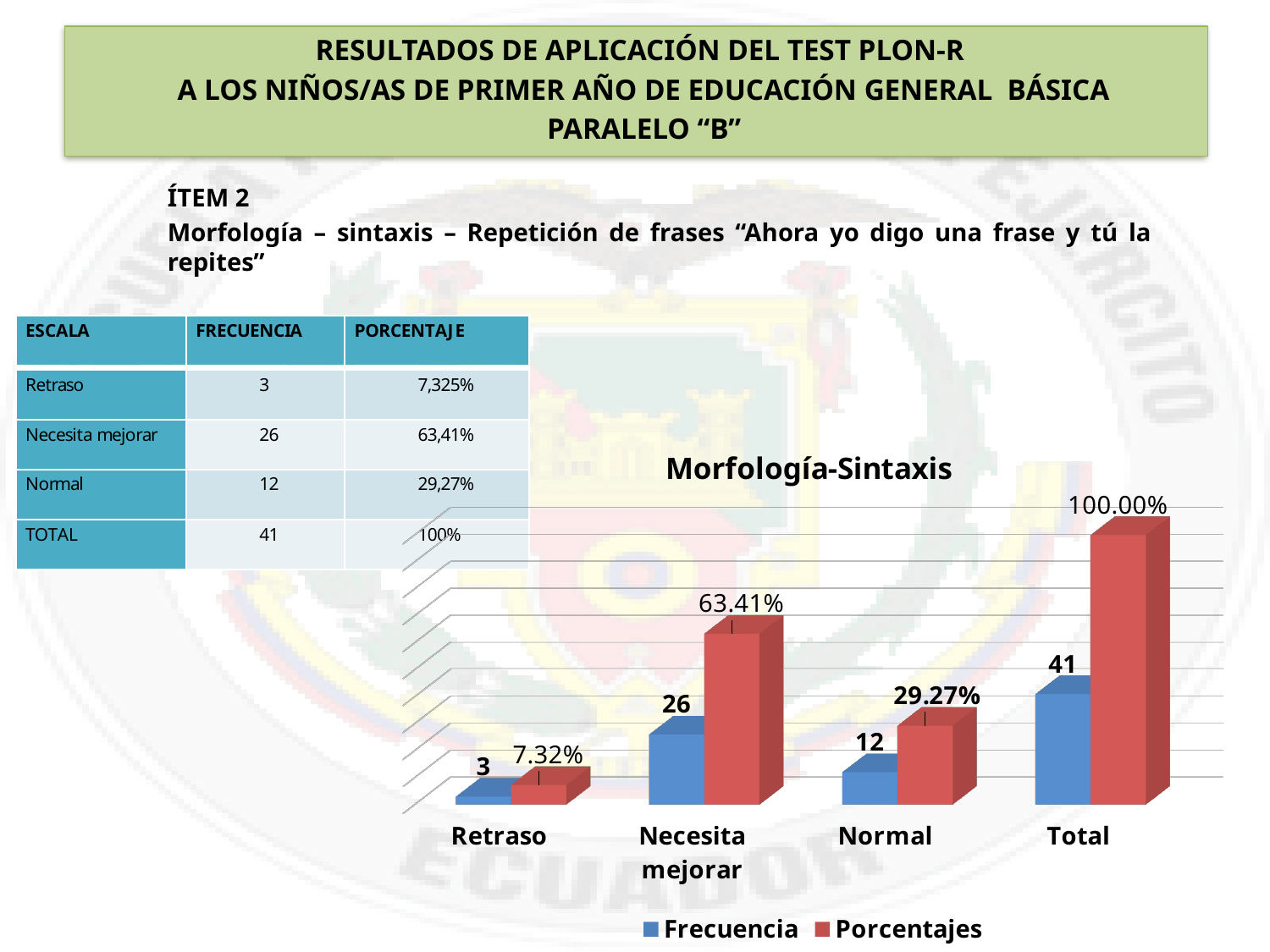
Which category has the lowest Porcentajes value? Retraso What is the Frecuencia value for Necesita mejorar? 26 Which is larger, the Frecuencia value for Normal or the Frecuencia value for Retraso? Normal What is the Frecuencia value for Retraso? 3 How many series does the chart legend list? 2 What is the title of the chart? Morfología-Sintaxis What is the Porcentajes value for Normal? 29.27% What is the difference between the Frecuencia values for Necesita mejorar and Normal? 14 What is the Porcentajes value for Total? 100.00% Excluding Total, which category has the highest Frecuencia value? Necesita mejorar How many categories are shown on the x axis of the chart? 4 What type of chart is shown on the slide? bar chart